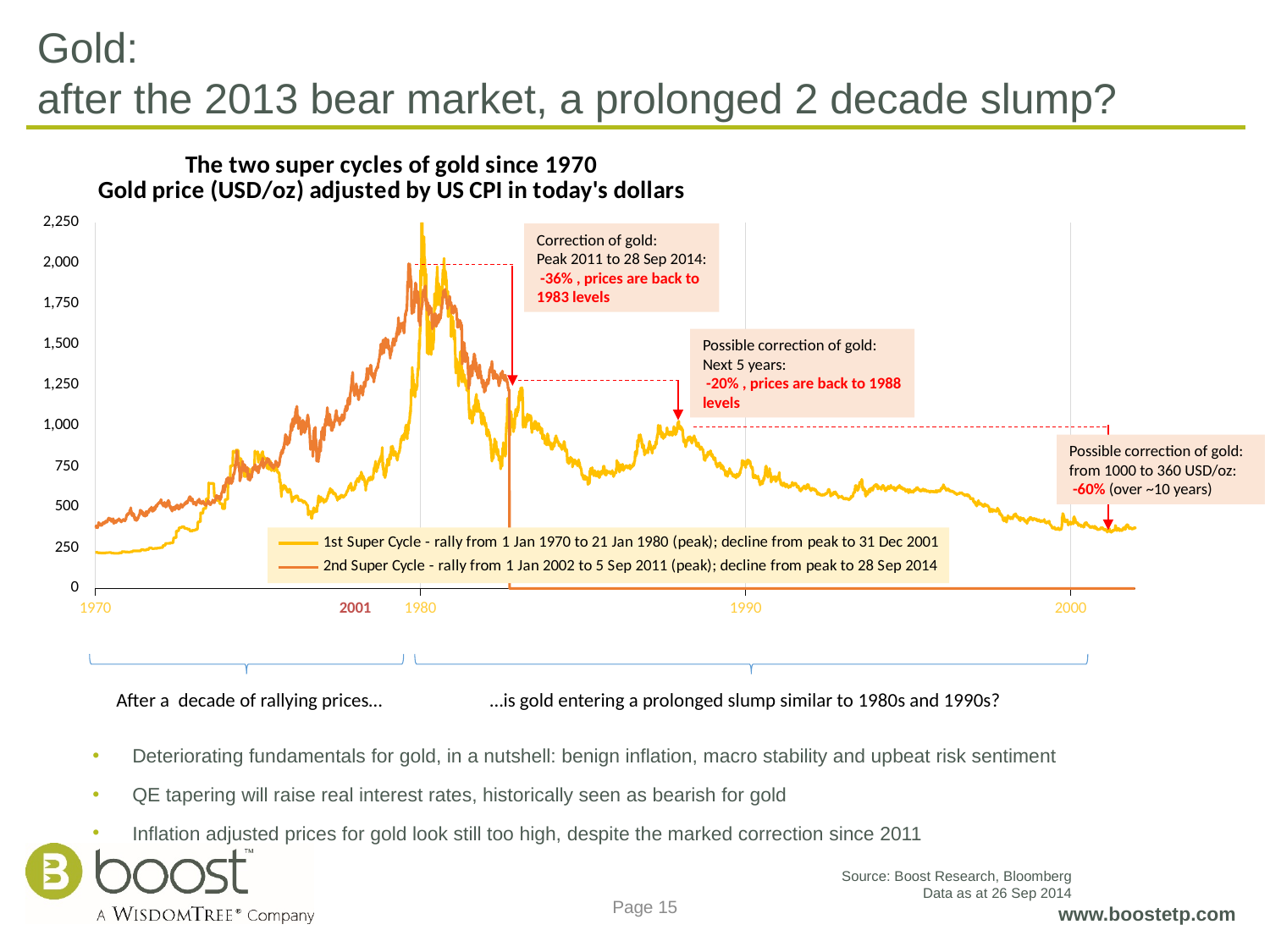
Which colour is used for the 1st Super Cycle line? yellow According to the annotation, what was the correction of gold from the 2011 peak to 28 Sep 2014? -36% What kind of chart is shown on the slide? line chart According to the annotation, what is the possible correction of gold over the next 5 years? -20% How many series does the chart legend list? 2 Is the value of the 1st Super Cycle line at 2000 greater or less than 500? less What is the title of the chart? The two super cycles of gold since 1970 Gold price (USD/oz) adjusted by US CPI in today's dollars Which series reaches the higher peak value, the 1st Super Cycle or the 2nd Super Cycle? 1st Super Cycle Does the 1st Super Cycle line rise or fall between 1970 and 1980? rise Does the 1st Super Cycle line rise or fall between 1980 and 2000? fall Is the peak value of the 1st Super Cycle line greater or less than 2,000? greater According to the annotation, what is the possible correction of gold from 1000 to 360 USD/oz? -60%